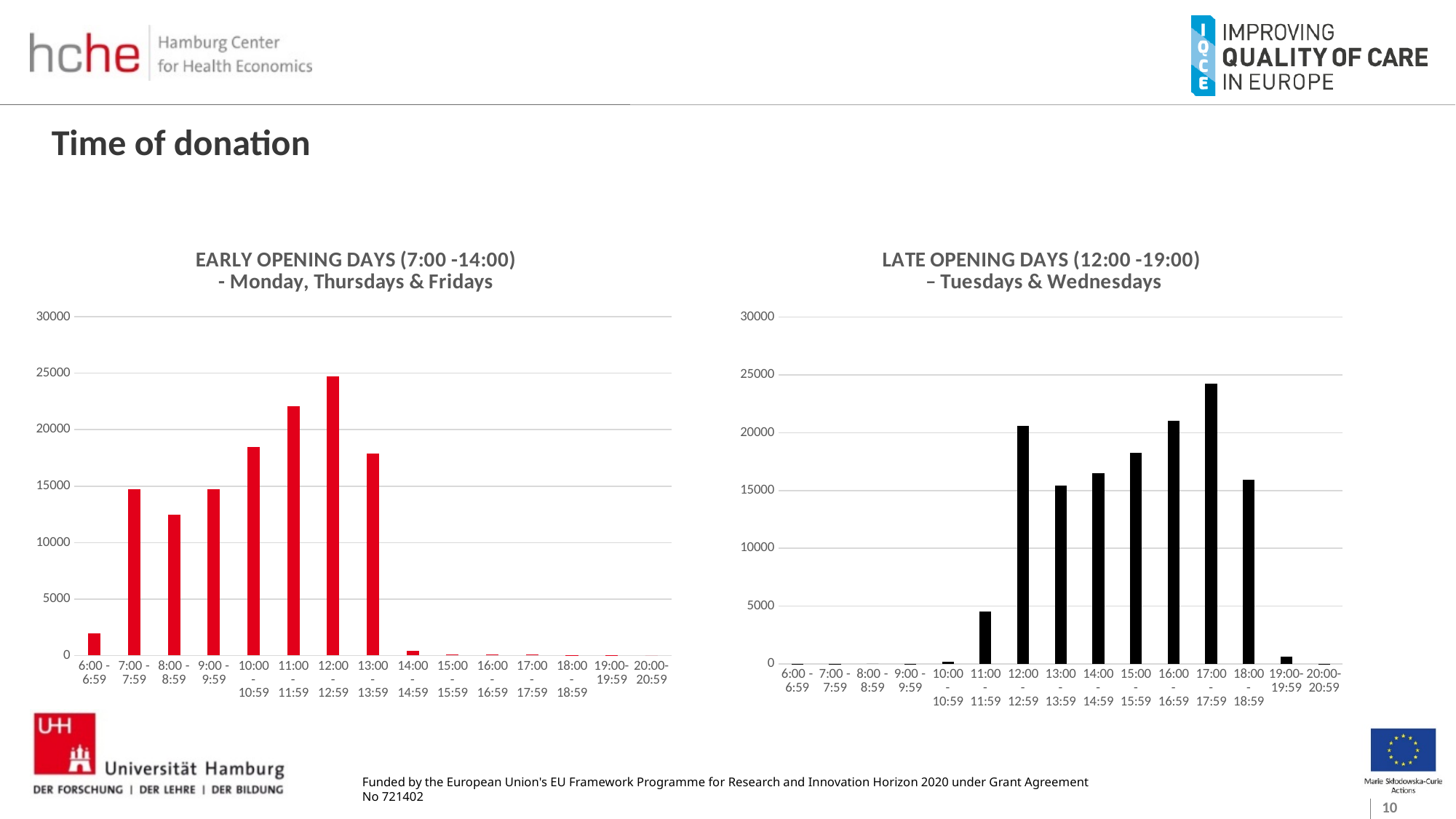
In the 'EARLY OPENING DAYS' chart on the left, which time slot has the highest value? 12:00 - 12:59 In the 'LATE OPENING DAYS' chart on the right, is the value for 15:00 - 15:59 greater or less than 15000? greater In the 'LATE OPENING DAYS' chart on the right, which is larger: the value for 17:00 - 17:59 or for 14:00 - 14:59? 17:00 - 17:59 In the 'LATE OPENING DAYS' chart on the right, which time slot has the highest value? 17:00 - 17:59 Which days does the 'EARLY OPENING DAYS' chart on the left cover, according to its title? Monday, Thursdays & Fridays What kind of chart is the 'EARLY OPENING DAYS (7:00 -14:00)' chart on the left? Bar chart How many time-slot categories are shown on the x axis of the 'EARLY OPENING DAYS' chart on the left? 15 In the 'LATE OPENING DAYS' chart on the right, is the value for 18:00 - 18:59 greater or less than 20000? less What colour are the bars in the 'LATE OPENING DAYS' chart on the right? Black In the 'EARLY OPENING DAYS' chart on the left, which is larger: the value for 11:00 - 11:59 or for 13:00 - 13:59? 11:00 - 11:59 In the 'EARLY OPENING DAYS' chart on the left, is the value for 10:00 - 10:59 greater or less than 15000? greater